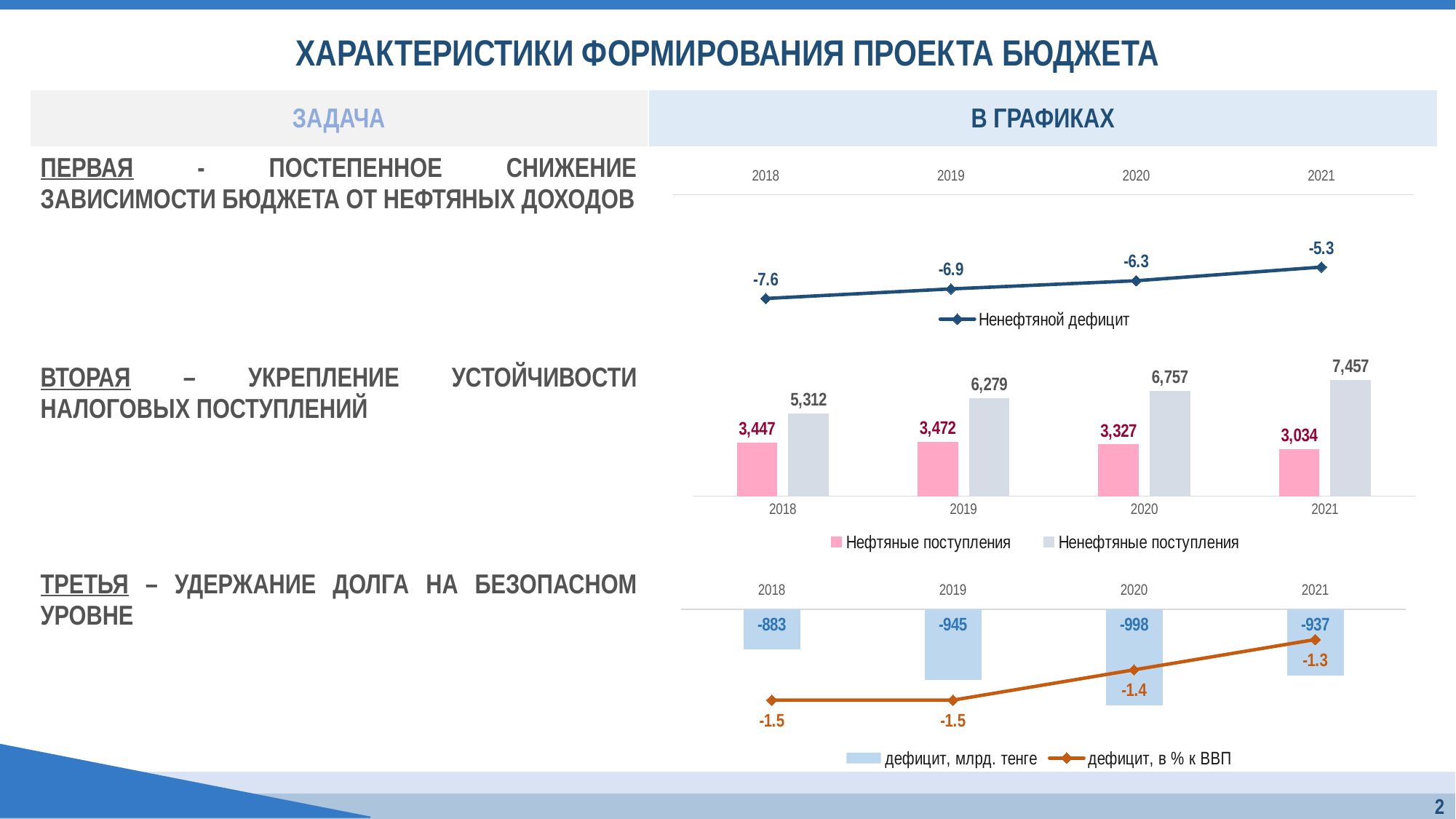
In the top chart, what is the value of Ненефтяной дефицит for 2018? -7.6 In the bottom chart, how many years are shown on the x axis? 4 In the middle chart, how many series does the legend list? 2 In the middle chart, what is the value of Ненефтяные поступления for 2020? 6,757 In the middle chart, which year has the lowest value of Нефтяные поступления? 2021 In the middle chart, which year has the highest value of Ненефтяные поступления? 2021 In the bottom chart, what is the value of дефицит, в % к ВВП for 2021? -1.3 In the middle chart, what is the value of Нефтяные поступления for 2021? 3,034 In the middle chart, what is the difference between Ненефтяные поступления and Нефтяные поступления in 2019? 2,807 In the top chart, does the Ненефтяной дефицит line rise or fall from 2018 to 2021? rise In the top chart, what is the value of Ненефтяной дефицит for 2021? -5.3 In the bottom chart, what is the value of дефицит, млрд. тенге for 2020? -998